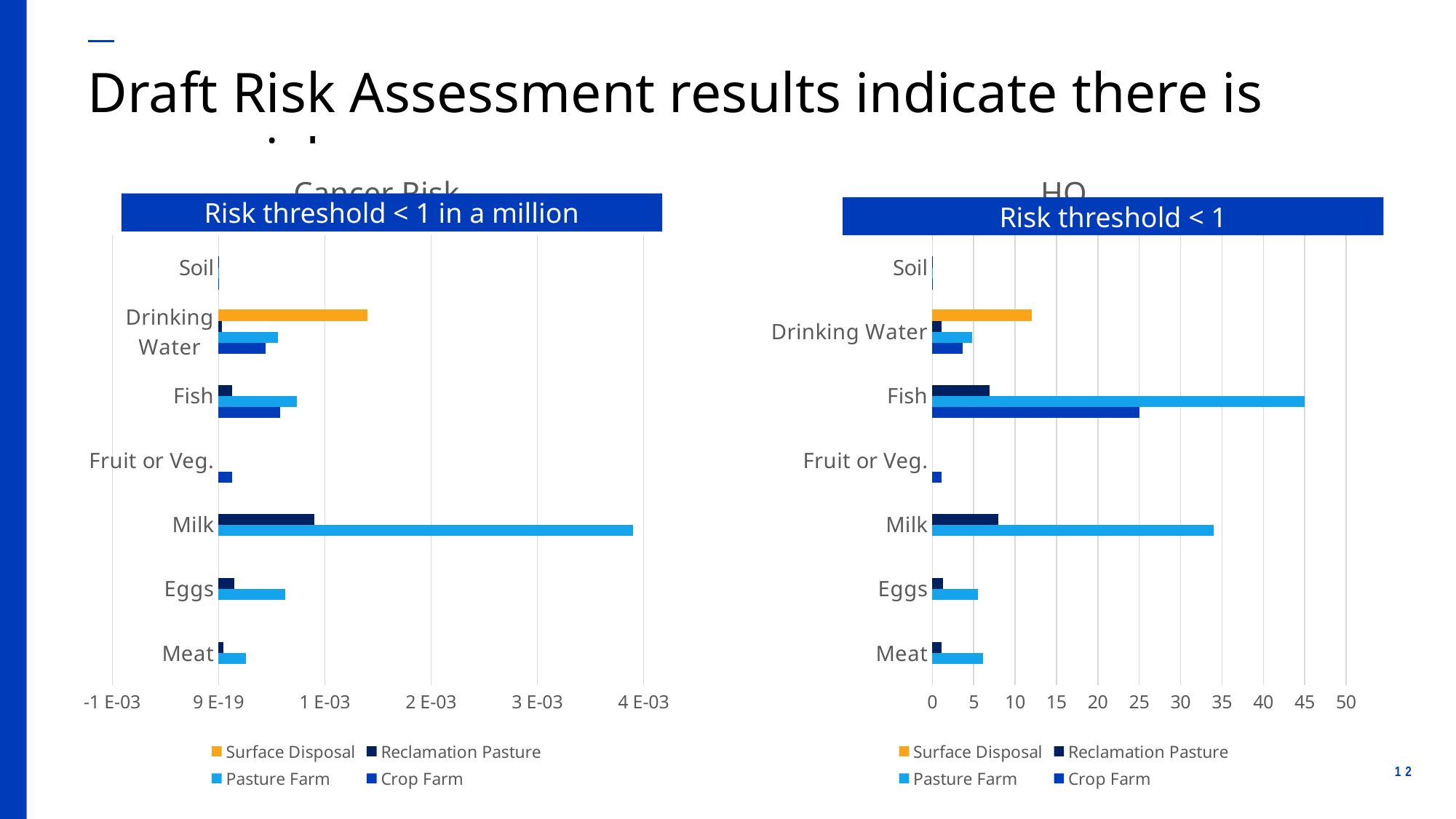
In the left chart (Cancer Risk), is the Surface Disposal value for Drinking Water greater or less than 1 E-03? greater In the left chart (Cancer Risk), which category has the longest bar overall? Milk In the right chart (HQ), is the Pasture Farm value for Eggs greater or less than 10? less In the right chart (HQ), which is larger: the Pasture Farm value for Fish or the Pasture Farm value for Milk? Fish What text is shown in the blue banner over the right chart (HQ)? Risk threshold < 1 In the right chart (HQ), which category has the longest bar overall? Fish In the right chart (HQ), is the Pasture Farm value for Milk greater or less than 30? greater How many series does the legend of the left chart (Cancer Risk) list? 4 How many categories are listed on the vertical axis of the right chart (HQ)? 7 What kind of chart is the left chart (Cancer Risk)? bar chart